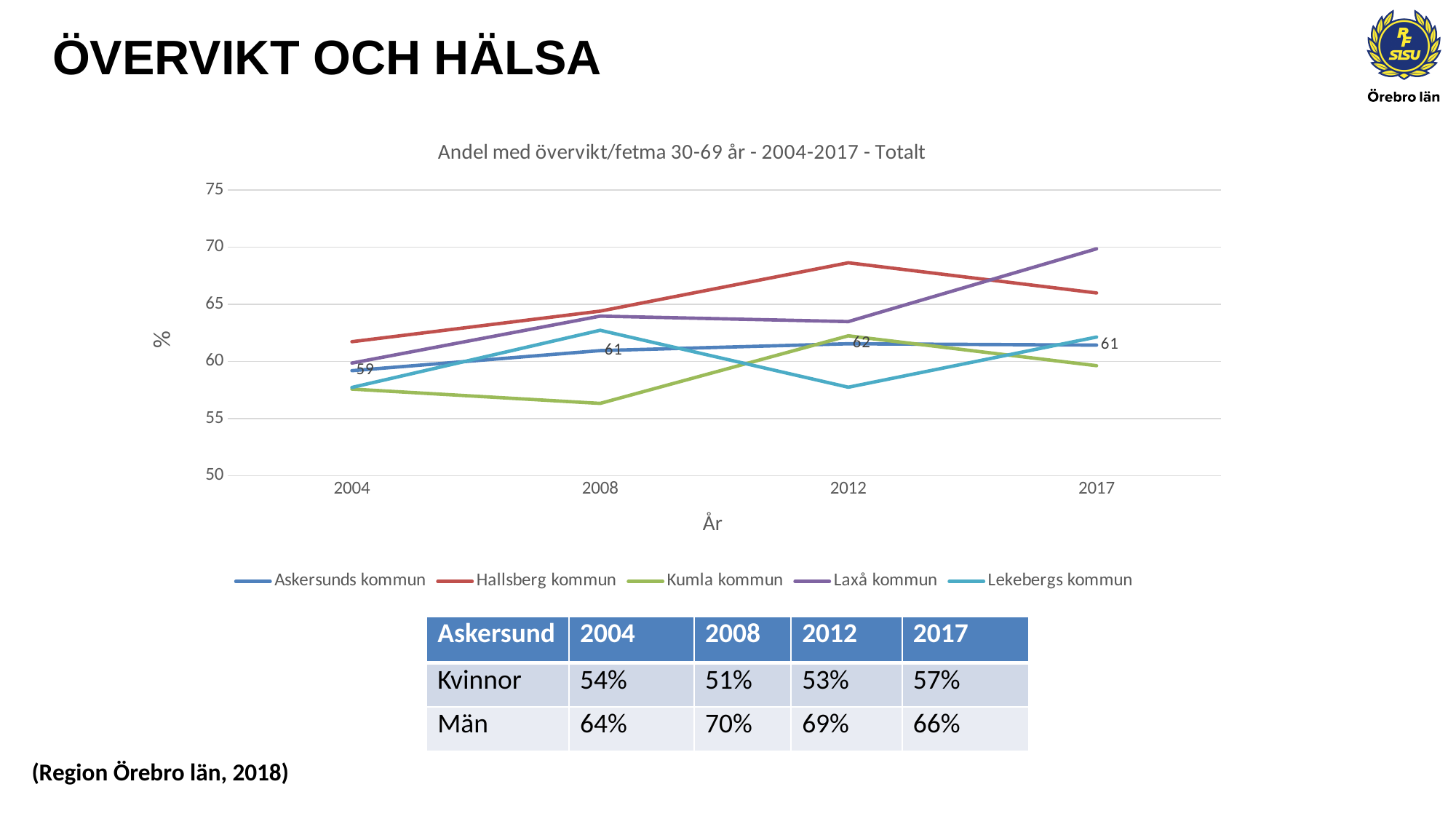
What is the value for Askersunds kommun in 2017? 61 How many series does the chart legend list? 5 Which municipality has the highest value in 2017? Laxå kommun Which is larger in 2004, the value for Hallsberg kommun or the value for Kumla kommun? Hallsberg kommun Is the value for Laxå kommun in 2017 greater or less than 65? greater What is the value for Askersunds kommun in 2004? 59 What is the title of the chart? Andel med övervikt/fetma 30-69 år - 2004-2017 - Totalt Which municipality has the lowest value in 2008? Kumla kommun How many years are plotted along the x axis of the chart? 4 What type of chart is shown on the slide? line chart What is the value for Askersunds kommun in 2012? 62 By how much did the value for Askersunds kommun increase from 2004 to 2012? 3